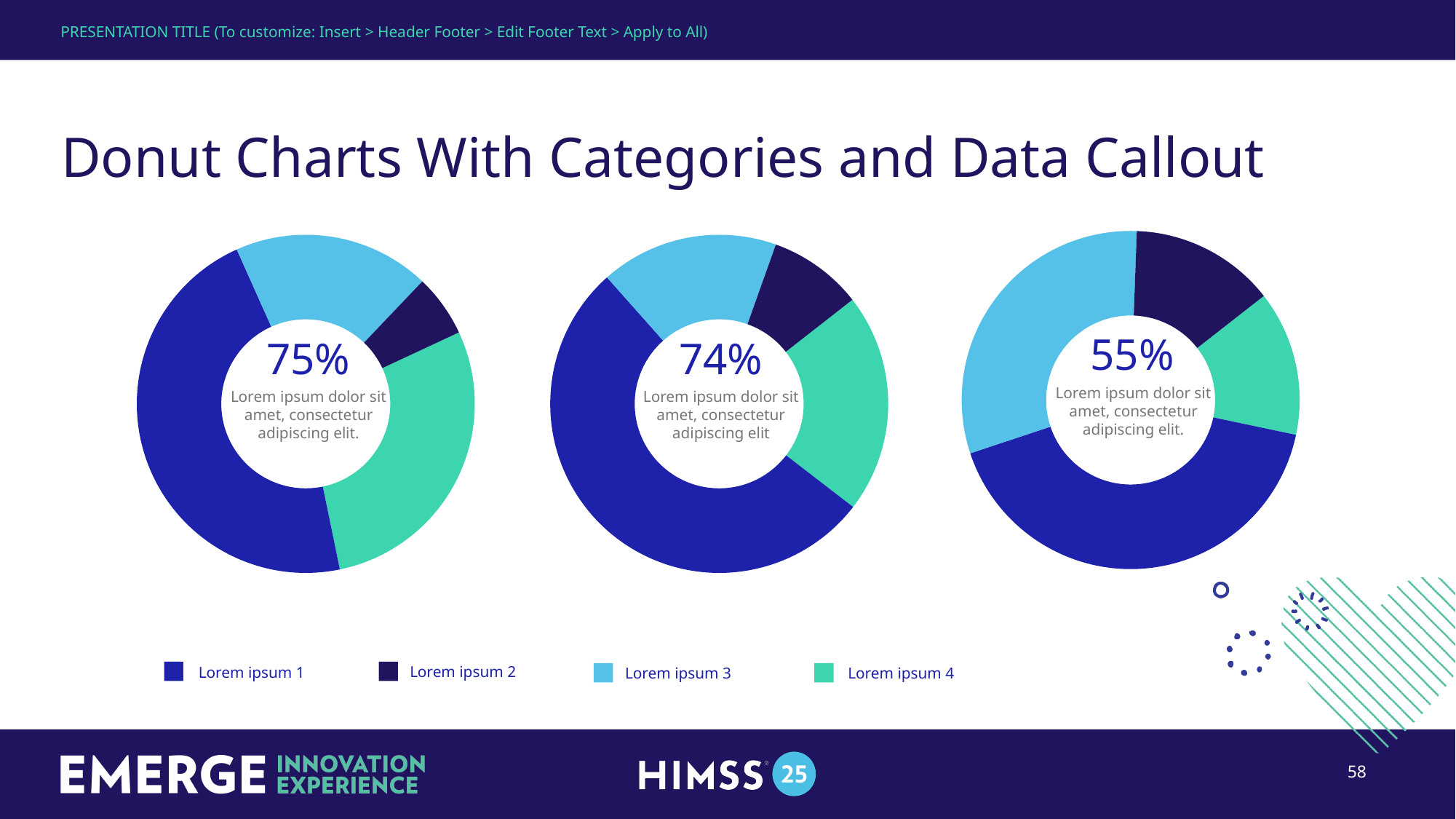
In the left donut chart, which category has the smallest slice? Lorem ipsum 2 In the middle donut chart, which category has the largest slice? Lorem ipsum 1 In the right donut chart, which category has the largest slice? Lorem ipsum 1 What percentage is shown in the centre of the right donut chart? 55% In the middle donut chart, which category has the smallest slice? Lorem ipsum 2 How many series does the legend list? 4 In the left donut chart, which category has the largest slice? Lorem ipsum 1 What kind of chart is shown on the left of the slide? Donut chart What percentage is shown in the centre of the left donut chart? 75% In the left donut chart, which slice is larger, Lorem ipsum 3 or Lorem ipsum 4? Lorem ipsum 4 What percentage is shown in the centre of the middle donut chart? 74% How many donut charts are on the slide? 3